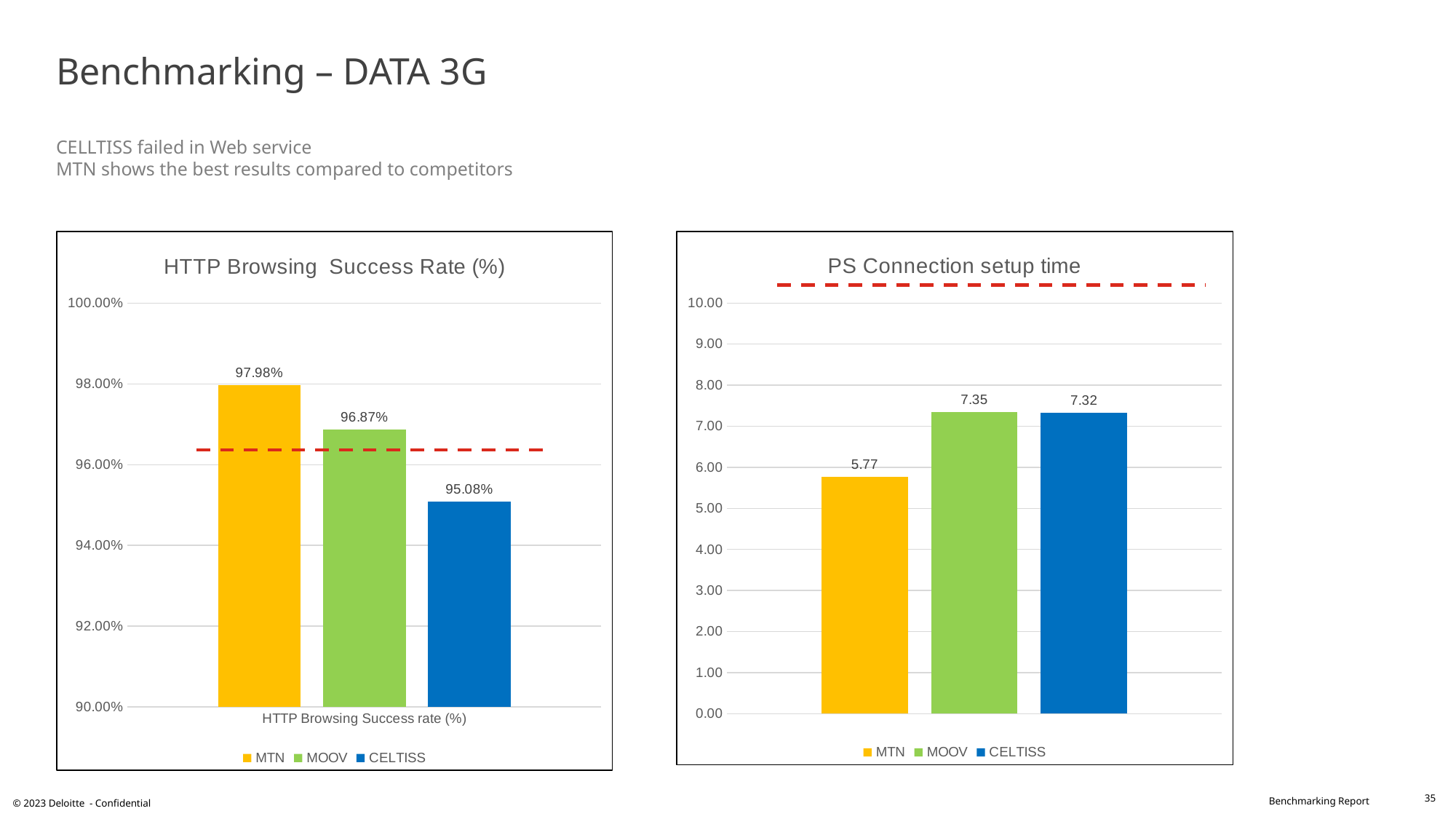
In the HTTP Browsing Success Rate (%) chart, how many series does the legend list? 3 In the HTTP Browsing Success Rate (%) chart, what is the difference between MTN and MOOV? 1.11% In the HTTP Browsing Success Rate (%) chart, which colour represents CELTISS? Blue In the HTTP Browsing Success Rate (%) chart, which operator has the lowest success rate? CELTISS In the HTTP Browsing Success Rate (%) chart, what is the value for CELTISS? 95.08% In the PS Connection setup time chart, what is the value for MTN? 5.77 In the PS Connection setup time chart, what is the value for MOOV? 7.35 In the PS Connection setup time chart, what is the difference between MOOV and MTN? 1.58 In the HTTP Browsing Success Rate (%) chart, what is the value for MTN? 97.98% What kind of chart is the PS Connection setup time chart? Bar chart In the PS Connection setup time chart, which operator has the highest setup time? MOOV In the PS Connection setup time chart, is the value for MTN greater or less than 6.00? less